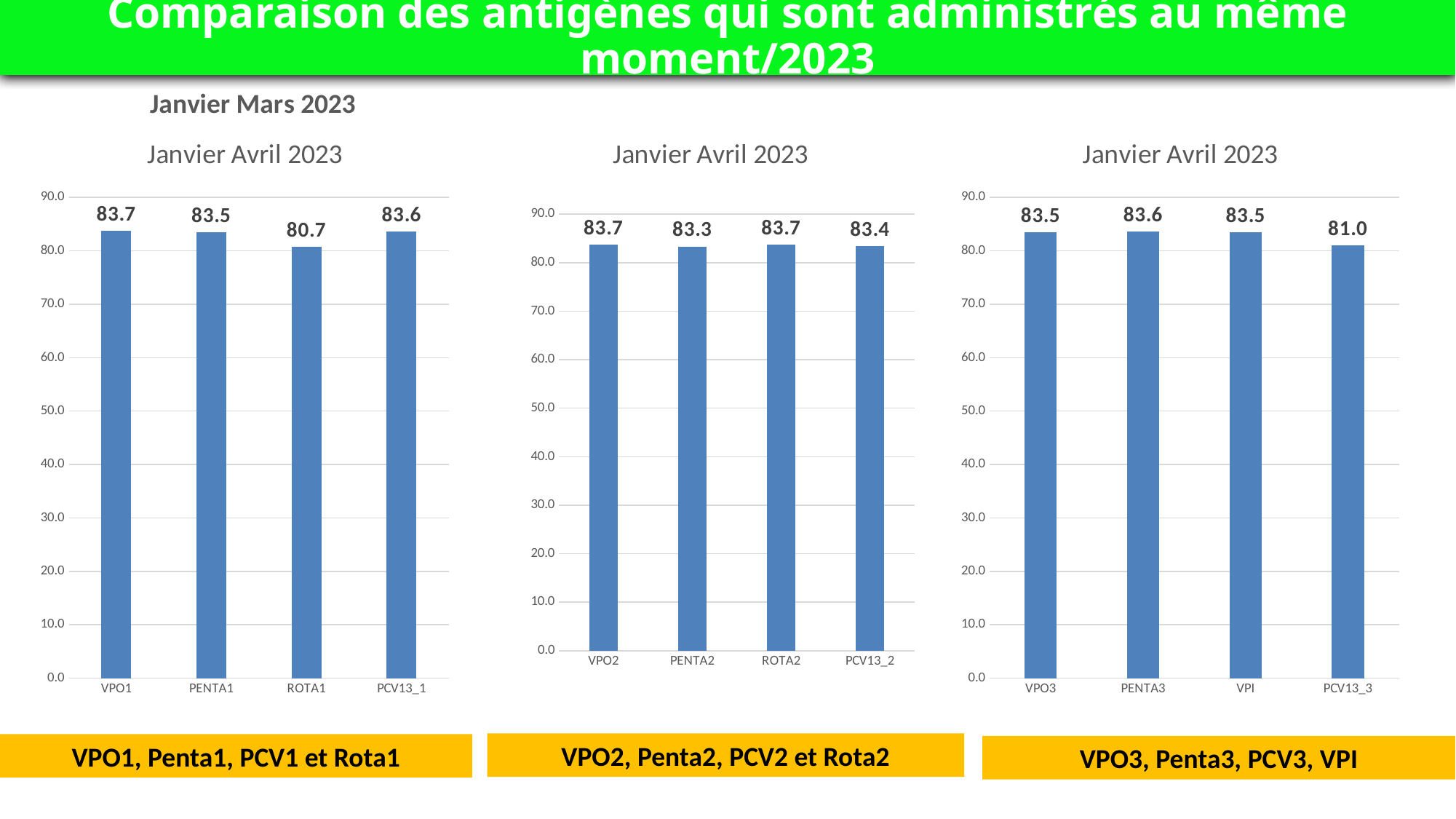
In the left chart, what is the difference between the values for VPO1 and ROTA1? 3.0 In the left chart, which category has the lowest value? ROTA1 In the middle chart, which is larger, the value for VPO2 or the value for PENTA2? VPO2 In the right chart, what is the value for PENTA3? 83.6 In the right chart, what is the difference between the values for PENTA3 and PCV13_3? 2.6 In the middle chart, what is the value for PENTA2? 83.3 In the right chart, which category has the lowest value? PCV13_3 What type of chart is the right chart? Bar chart How many bars are shown in the middle chart? 4 In the left chart, what is the value for ROTA1? 80.7 In the right chart, what is the value for PCV13_3? 81.0 In the left chart, what is the value for VPO1? 83.7